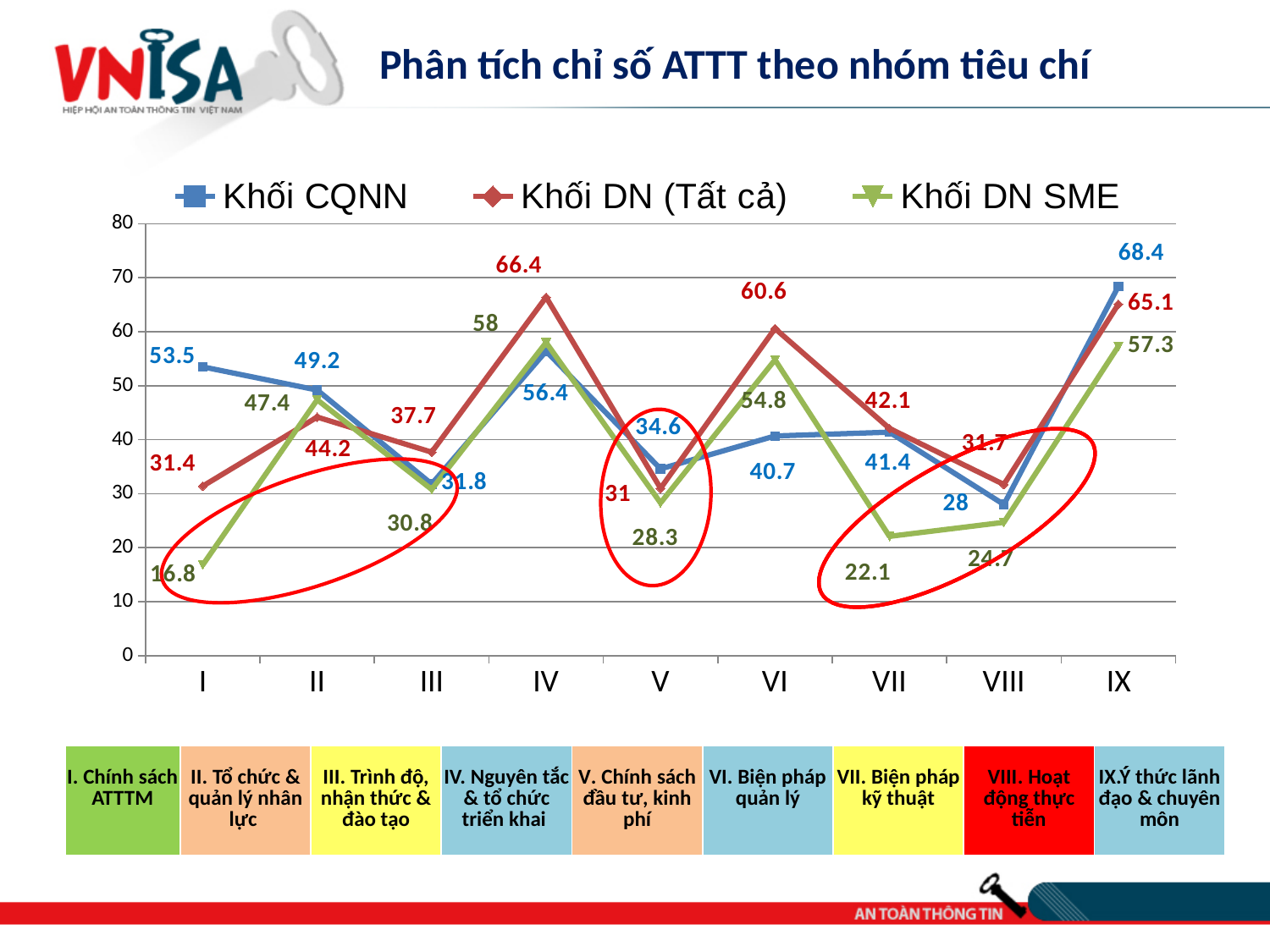
What is the value for Khối CQNN at category V? 34.6 What is the value for Khối DN SME at category I? 16.8 At which category does Khối CQNN reach its highest value? IX At which category does Khối DN SME have its lowest value? I How many categories are plotted along the x axis? 9 At which category does Khối DN (Tất cả) reach its highest value? IV What kind of chart is shown on the slide? line chart How many series does the legend list? 3 What is the title of the chart? Phân tích chỉ số ATTT theo nhóm tiêu chí What is the difference between Khối CQNN and Khối DN SME at category I? 36.7 What is the value for Khối DN (Tất cả) at category IV? 66.4 At category VI, which is larger: Khối DN (Tất cả) or Khối CQNN? Khối DN (Tất cả)